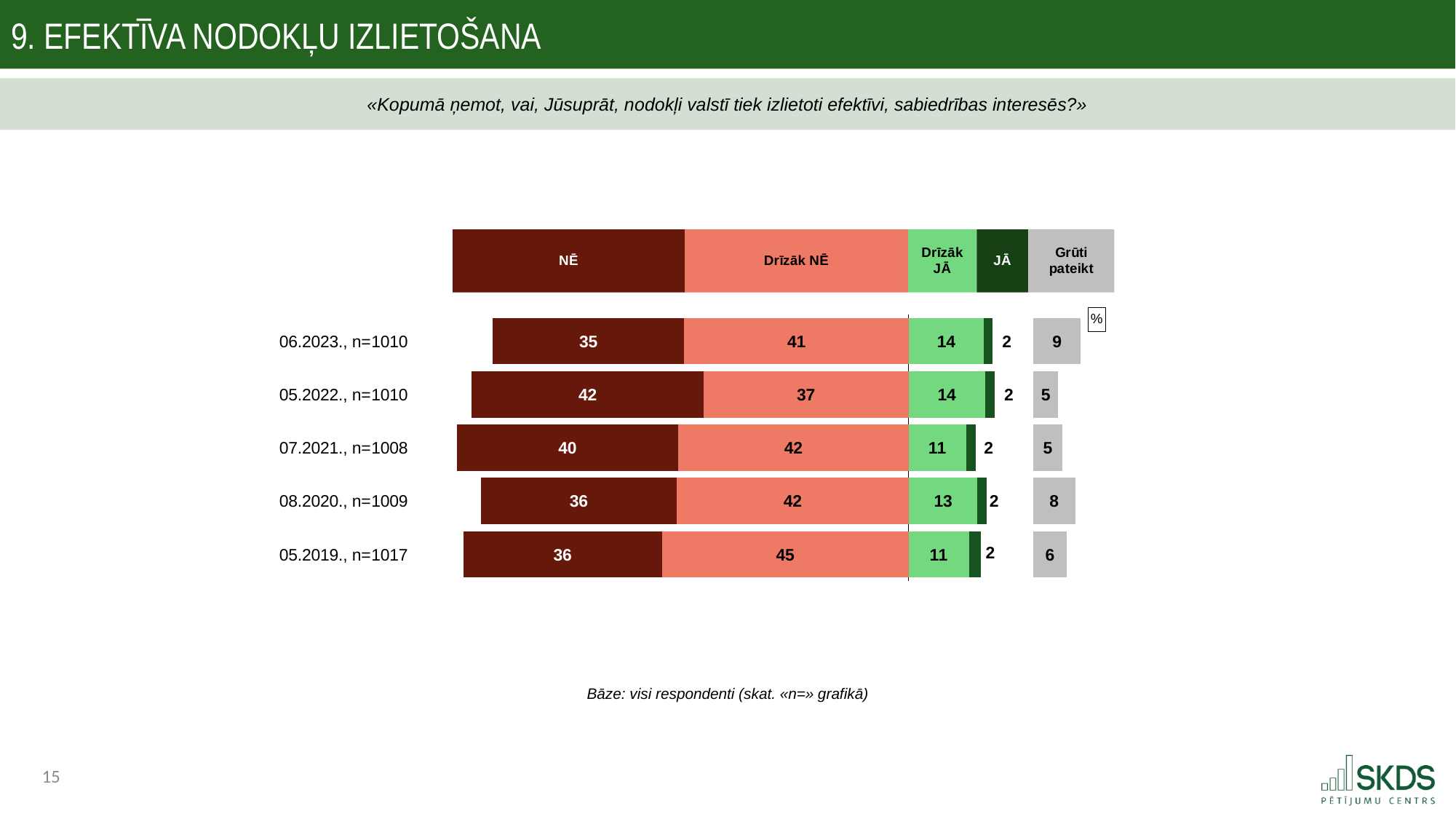
What is the combined total of "NĒ" and "Drīzāk NĒ" for 07.2021., n=1008? 82 How many survey rows (time points) are shown in the chart? 5 Which row has the lowest value for "Grūti pateikt"? 05.2022., n=1010 and 07.2021., n=1008 Which row has the highest value for "NĒ"? 05.2022., n=1010 What is the value for "Drīzāk NĒ" in the 05.2019., n=1017 row? 45 What colour represents the "JĀ" category in the legend? Dark green What is the value for "NĒ" in the 06.2023., n=1010 row? 35 What is the value for "Grūti pateikt" in the 08.2020., n=1009 row? 8 What is the difference between the "NĒ" values for 05.2022., n=1010 and 06.2023., n=1010? 7 How many response categories does the legend list? 5 What kind of chart is shown on the slide? Stacked bar chart Which is larger: the "Drīzāk JĀ" value for 06.2023., n=1010 or for 07.2021., n=1008? 06.2023., n=1010